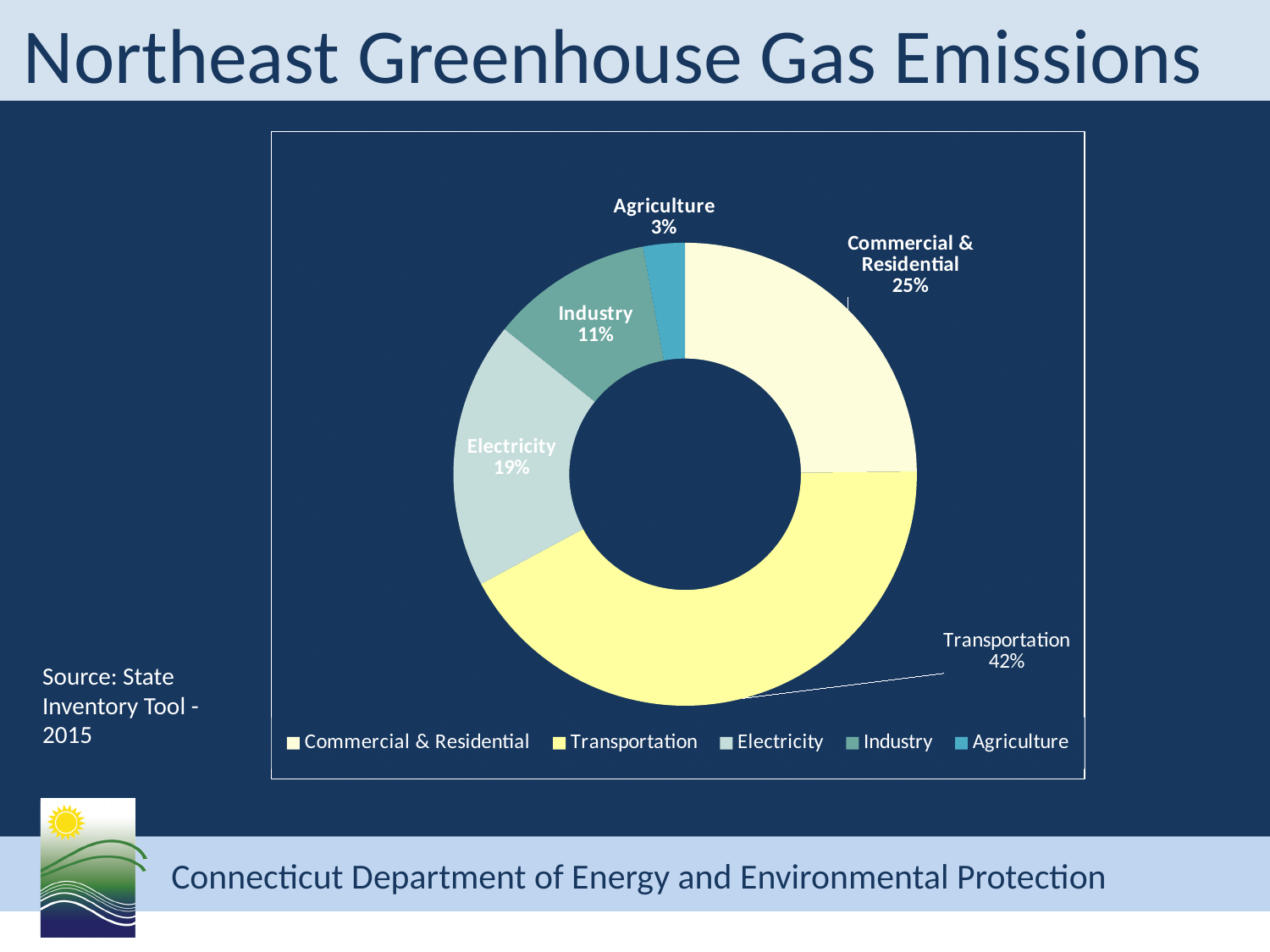
Which sector accounts for the largest share of emissions? Transportation What share of emissions is attributed to Electricity? 19% What source is cited for the chart data? State Inventory Tool - 2015 Which sector accounts for the smallest share of emissions? Agriculture How many percentage points larger is the Transportation share than the Commercial & Residential share? 17 What type of chart is shown on the slide? Doughnut chart What is the difference in percentage points between Electricity and Industry? 8 What percentage of Northeast greenhouse gas emissions comes from Transportation? 42% What is the combined share of Commercial & Residential and Transportation? 67% How many sectors are shown in the chart? 5 Which is larger, the Commercial & Residential share or the Electricity share? Commercial & Residential What percentage of emissions comes from Industry? 11%